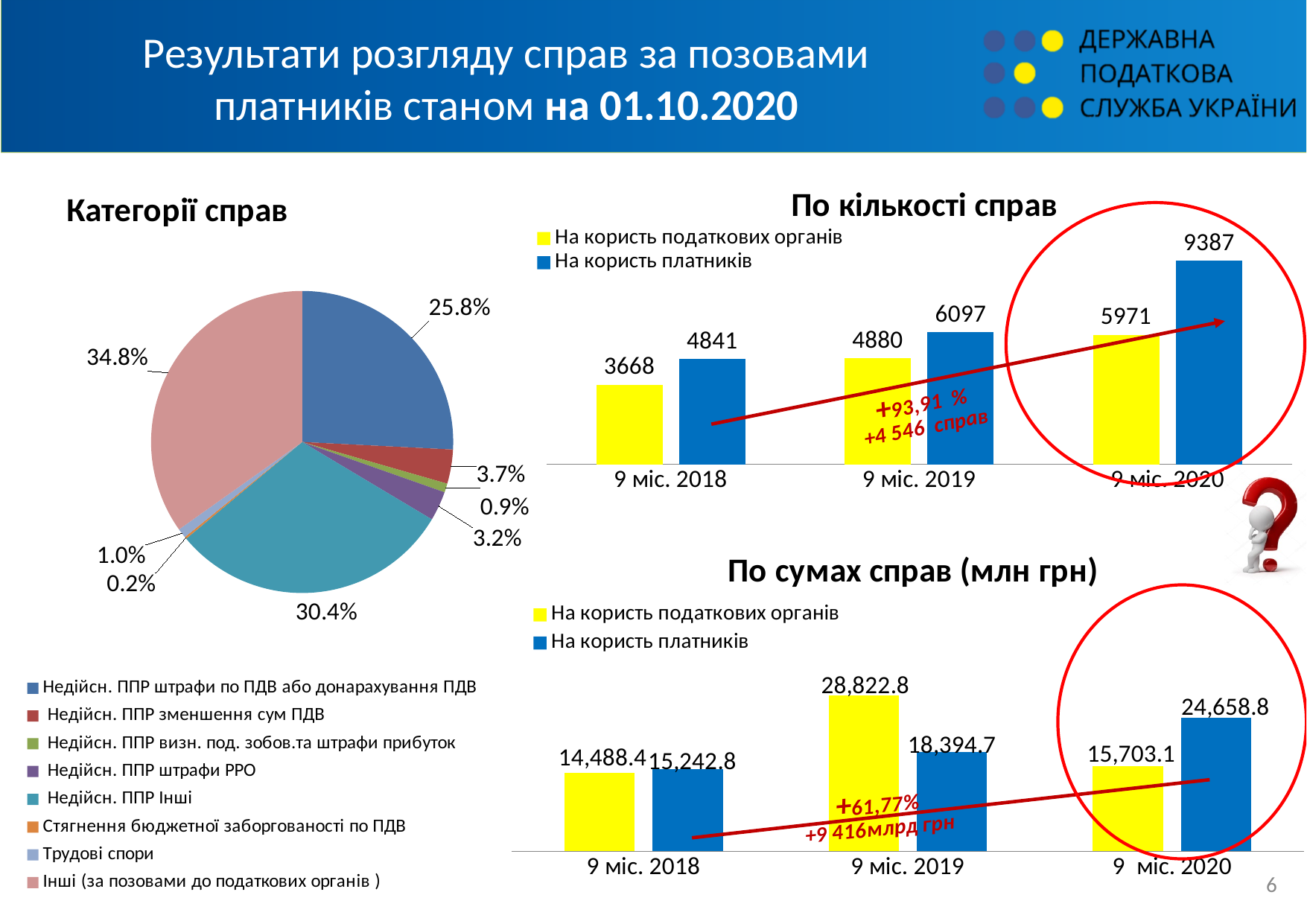
In the chart 'По сумах справ (млн грн)', which is larger in 9 міс. 2020: 'На користь податкових органів' or 'На користь платників'? На користь платників In the chart 'По кількості справ', which period has the highest value for 'На користь платників'? 9 міс. 2020 In the chart 'По кількості справ', what is the value for 'На користь податкових органів' in 9 міс. 2018? 3668 In the chart 'По сумах справ (млн грн)', how many series does the legend list? 2 In the chart 'По кількості справ', what is the difference between 'На користь платників' and 'На користь податкових органів' in 9 міс. 2019? 1217 What kind of chart is 'По кількості справ'? Bar chart In the pie chart 'Категорії справ', what share does 'Недійсн. ППР Інші' have? 30.4% In the chart 'По сумах справ (млн грн)', which period has the lowest value for 'На користь платників'? 9 міс. 2018 In the chart 'По сумах справ (млн грн)', what is the value for 'На користь податкових органів' in 9 міс. 2019? 28,822.8 In the pie chart 'Категорії справ', what share does 'Інші (за позовами до податкових органів )' have? 34.8% In the chart 'По кількості справ', what is the value for 'На користь платників' in 9 міс. 2020? 9387 In the pie chart 'Категорії справ', how many categories does the legend list? 8